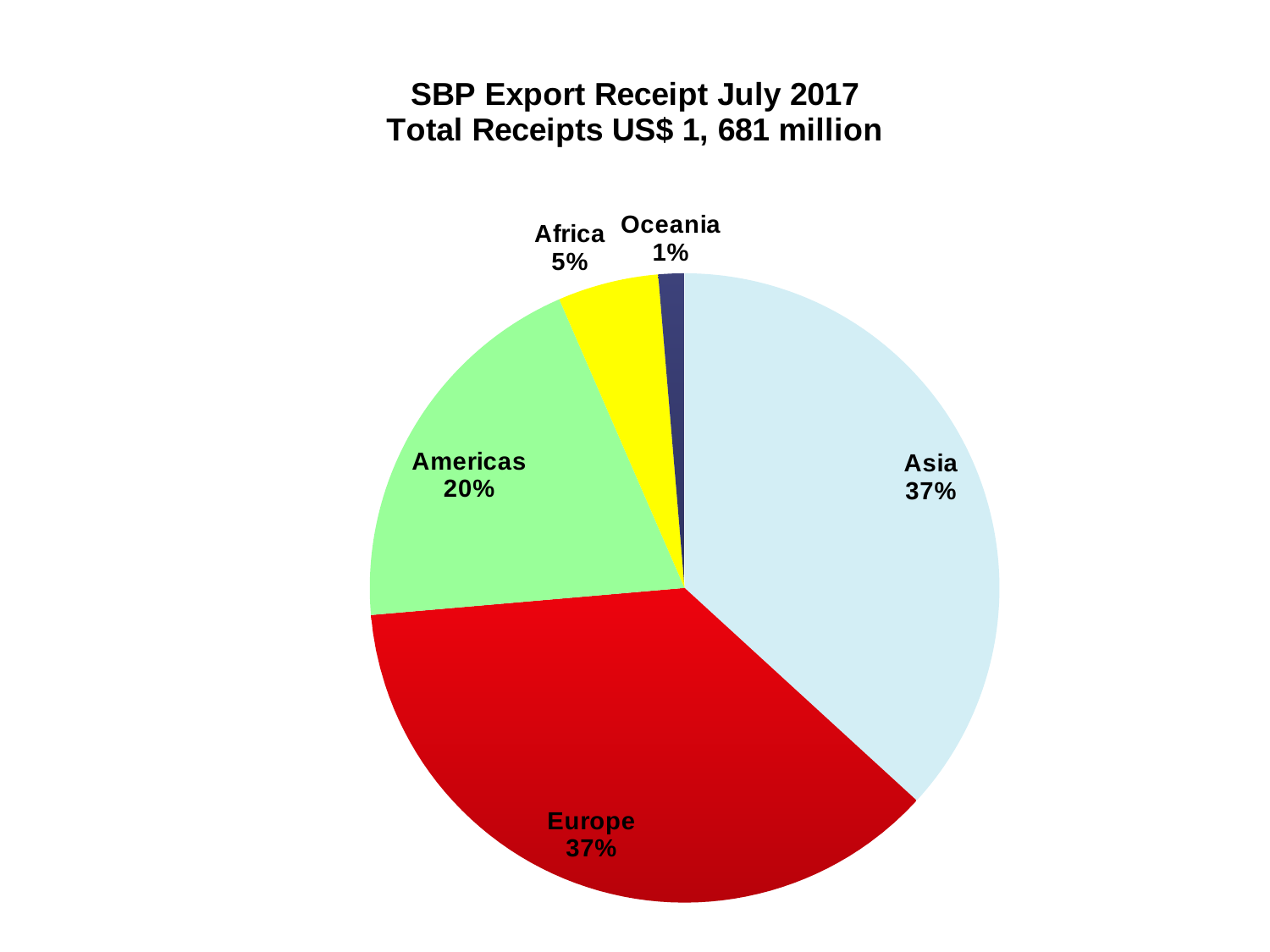
How many regions (slices) are shown in the pie chart? 5 What is the value shown for Europe? 37% What kind of chart is shown on the slide? Pie chart What is the value shown for Africa? 5% What is the difference in percentage points between the Africa share and the Oceania share? 4 percentage points What share of the pie does Asia account for? 37% What total receipts figure is stated in the chart title? US$ 1, 681 million Which is larger, the share for the Americas or the share for Africa? Americas What is the difference in percentage points between the Asia share and the Americas share? 17 percentage points Which region has the smallest share of the pie? Oceania Which month and year does the chart title refer to? July 2017 What is the value shown for the Americas? 20%